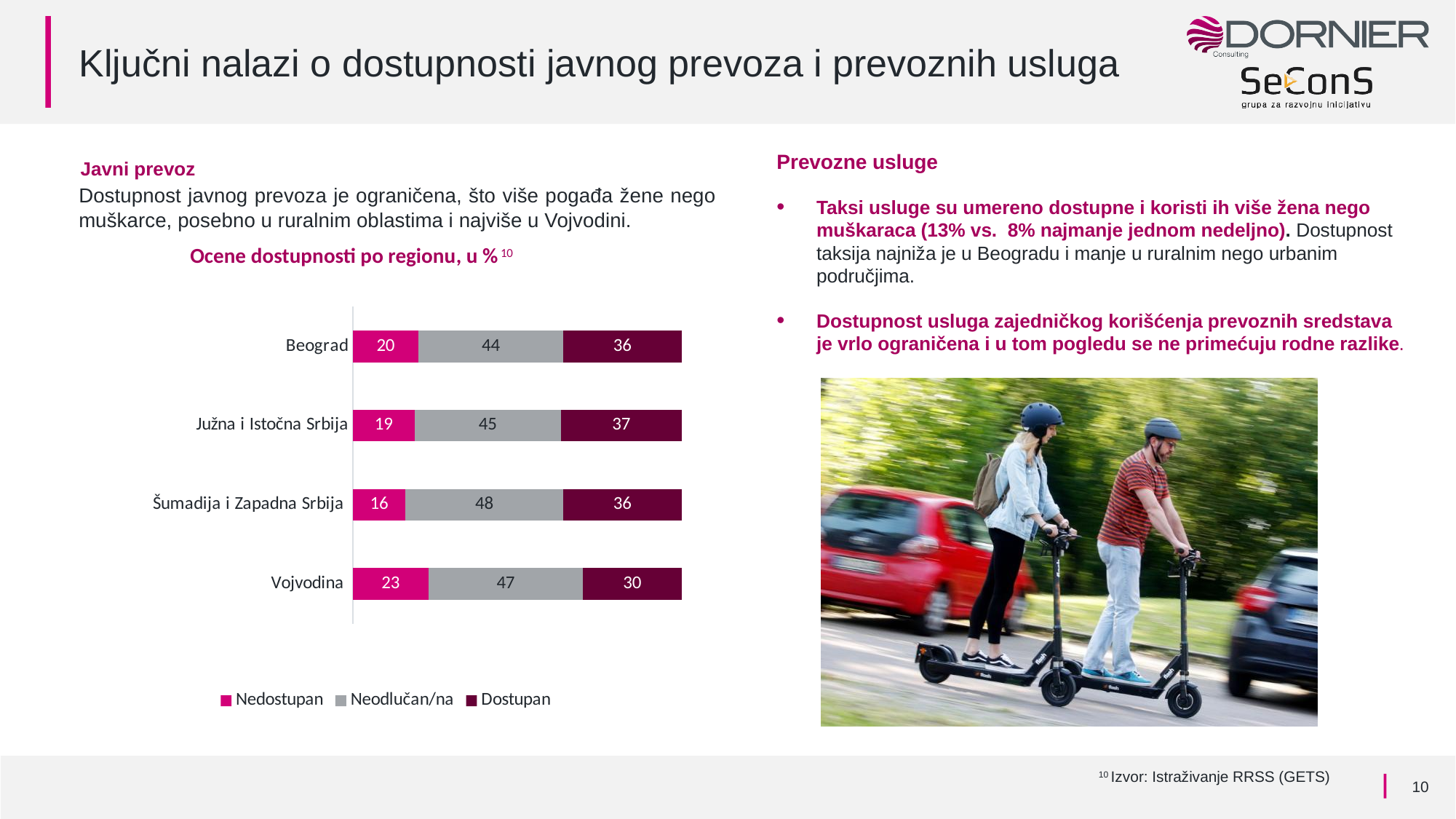
How many regions are shown in the chart? 4 What is the 'Dostupan' value for Vojvodina? 30 What kind of chart is shown on the slide? Stacked bar chart What is the 'Neodlučan/na' value for Šumadija i Zapadna Srbija? 48 What is the title of the chart? Ocene dostupnosti po regionu, u % How many series does the legend list? 3 Which region has the lowest 'Dostupan' value? Vojvodina Which region has the highest 'Nedostupan' value? Vojvodina What is the total of the stacked bar for Beograd? 100 What is the difference between the 'Dostupan' values for Južna i Istočna Srbija and Vojvodina? 7 Which is larger: the 'Nedostupan' value for Beograd or for Šumadija i Zapadna Srbija? Beograd What is the 'Nedostupan' value for Beograd? 20